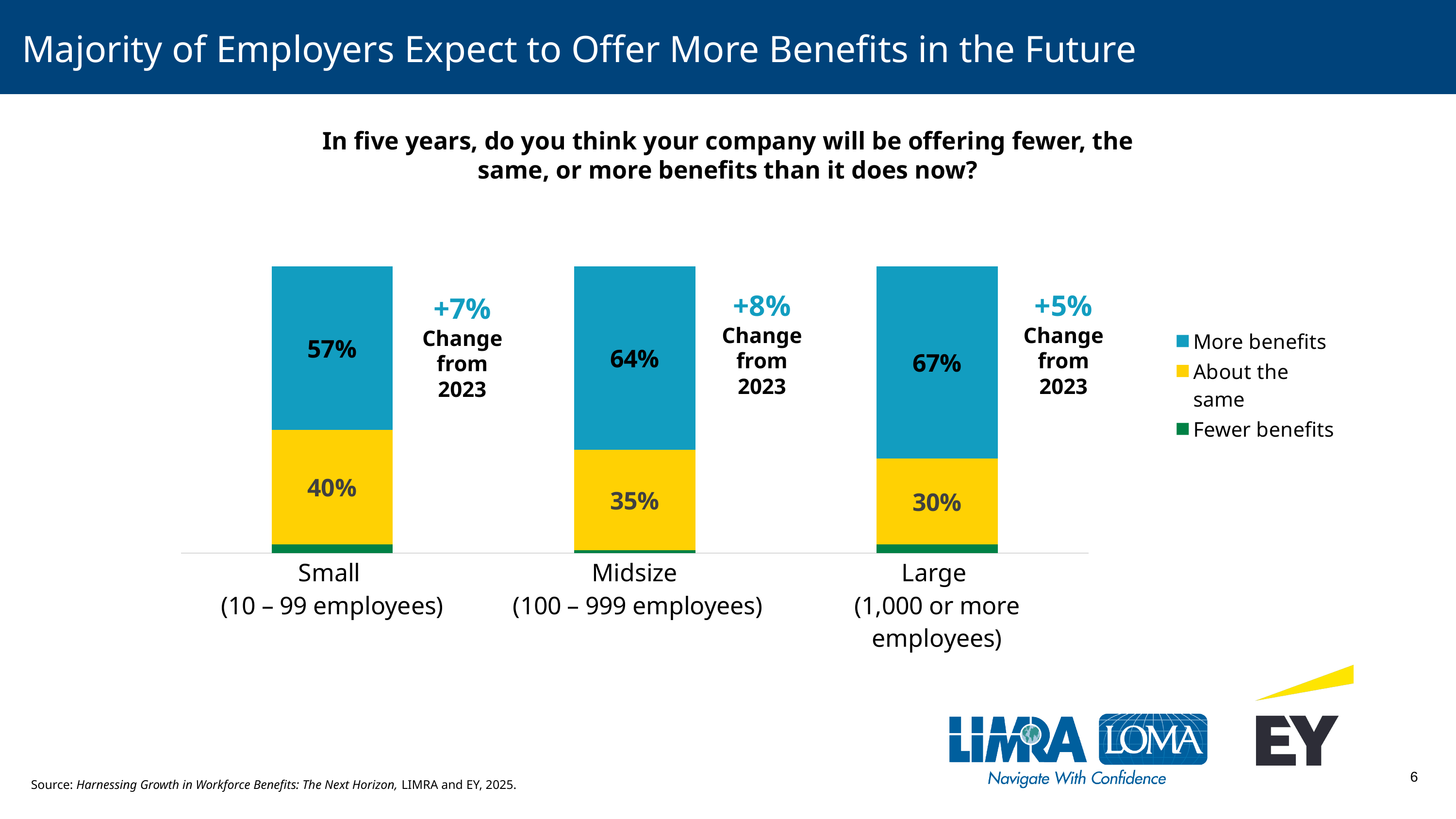
How many employer size categories are shown in the chart? 3 Which employer size group has the highest share expecting to offer more benefits? Large (1,000 or more employees) What type of chart is shown on the slide? Stacked bar chart Which is larger: the 'About the same' share for small employers or for midsize employers? Small employers Which employer size group has the lowest share expecting to offer about the same benefits? Large (1,000 or more employees) Which colour represents 'Fewer benefits' in the legend? Green What percentage of large employers (1,000 or more employees) expect to offer more benefits? 67% What percentage of small employers (10 – 99 employees) expect to offer more benefits in five years? 57% What is the change from 2023 shown for midsize employers? +8% How many series does the legend list? 3 What percentage of midsize employers (100 – 999 employees) expect to offer about the same benefits? 35% What is the difference between the 'More benefits' percentages for large and small employers? 10 percentage points